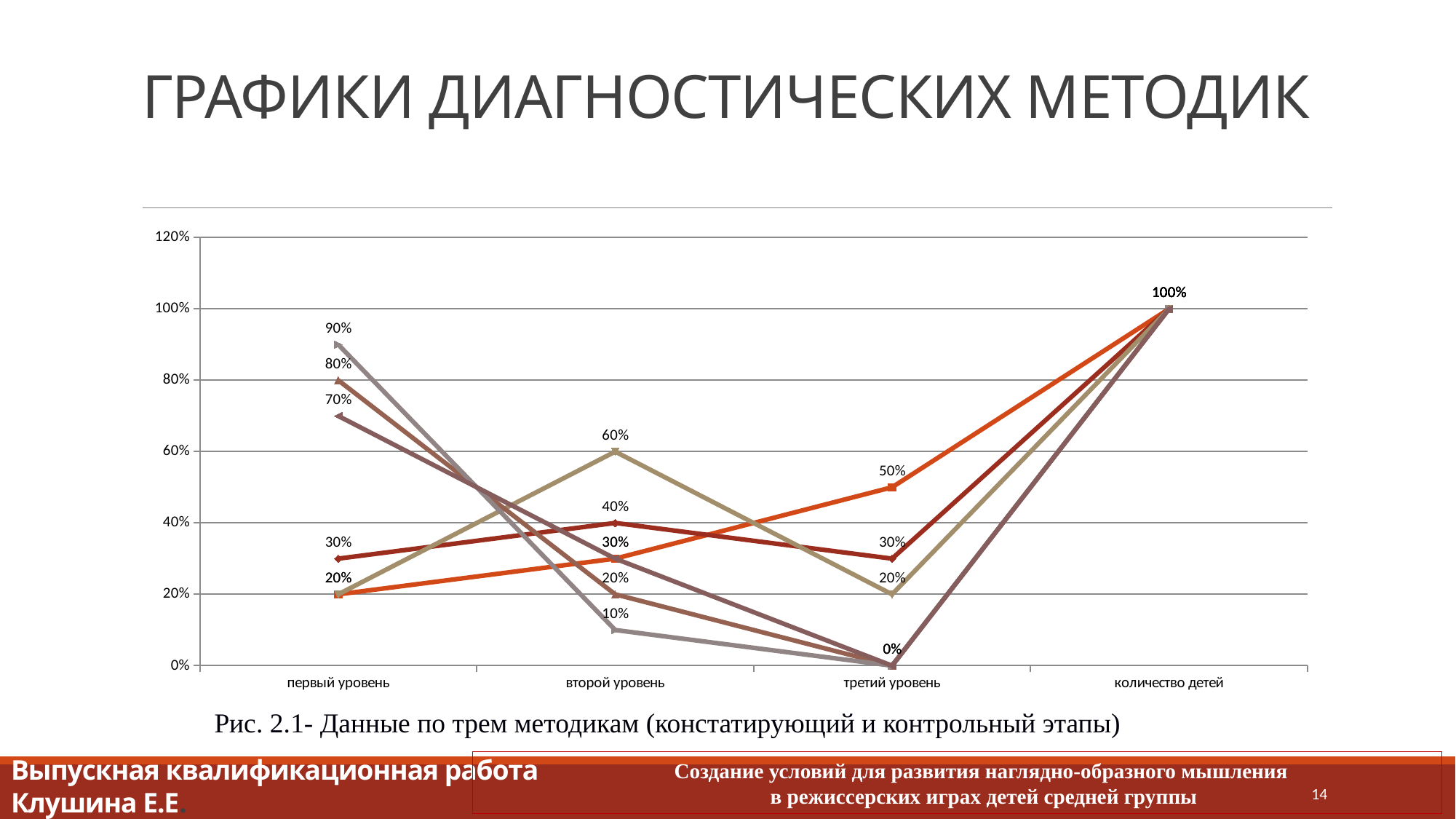
What is the figure caption written below the chart? Рис. 2.1- Данные по трем методикам (констатирующий и контрольный этапы) What is the lowest value labelled at 'первый уровень'? 20% What is the lowest value labelled at 'третий уровень'? 0% What is the difference between the highest and lowest labelled values at 'первый уровень'? 70% What is the highest value labelled at 'третий уровень'? 50% How many categories are shown on the x axis of the chart? 4 Is the highest value at 'третий уровень' greater or less than 60%? less What is the topmost tick value on the vertical axis? 120% What value do all the lines reach at the category 'количество детей'? 100% What is the highest value labelled at 'второй уровень'? 60% What kind of chart is shown on the slide? line chart What is the highest value labelled at 'первый уровень'? 90%